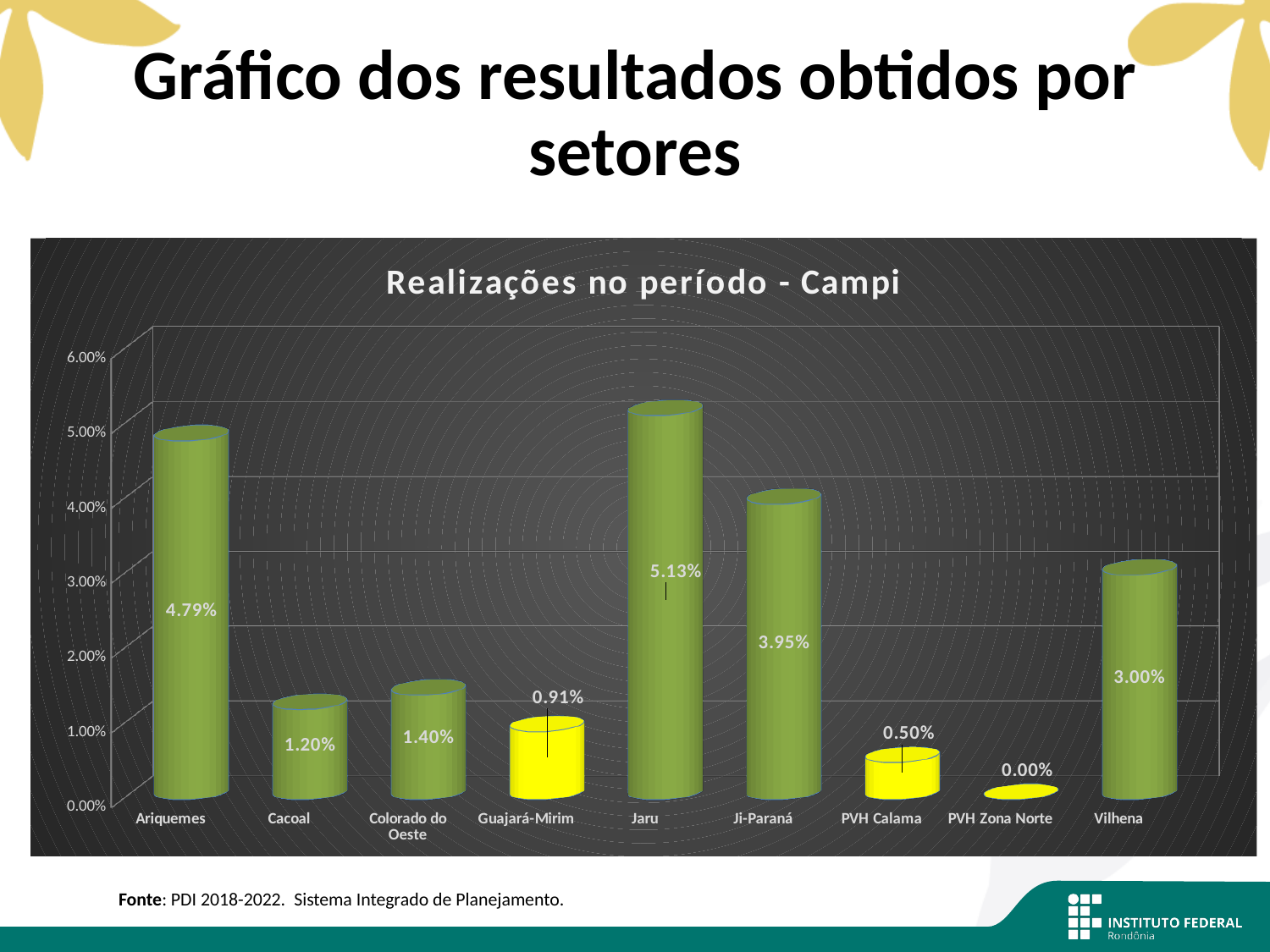
Which campus has the lowest value? PVH Zona Norte What is the value for Guajará-Mirim? 0.91% Is the value for Vilhena greater or less than 2.00%? greater What is the difference between the values for Jaru and Ariquemes? 0.34% How many campi are shown on the x axis? 9 What is the value for PVH Zona Norte? 0.00% What kind of chart is shown? bar chart Which campus has the highest value? Jaru What is the value for Ariquemes? 4.79% What is the title of the chart? Realizações no período - Campi What is the value for Ji-Paraná? 3.95% Which is larger, the value for Cacoal or the value for Colorado do Oeste? Colorado do Oeste